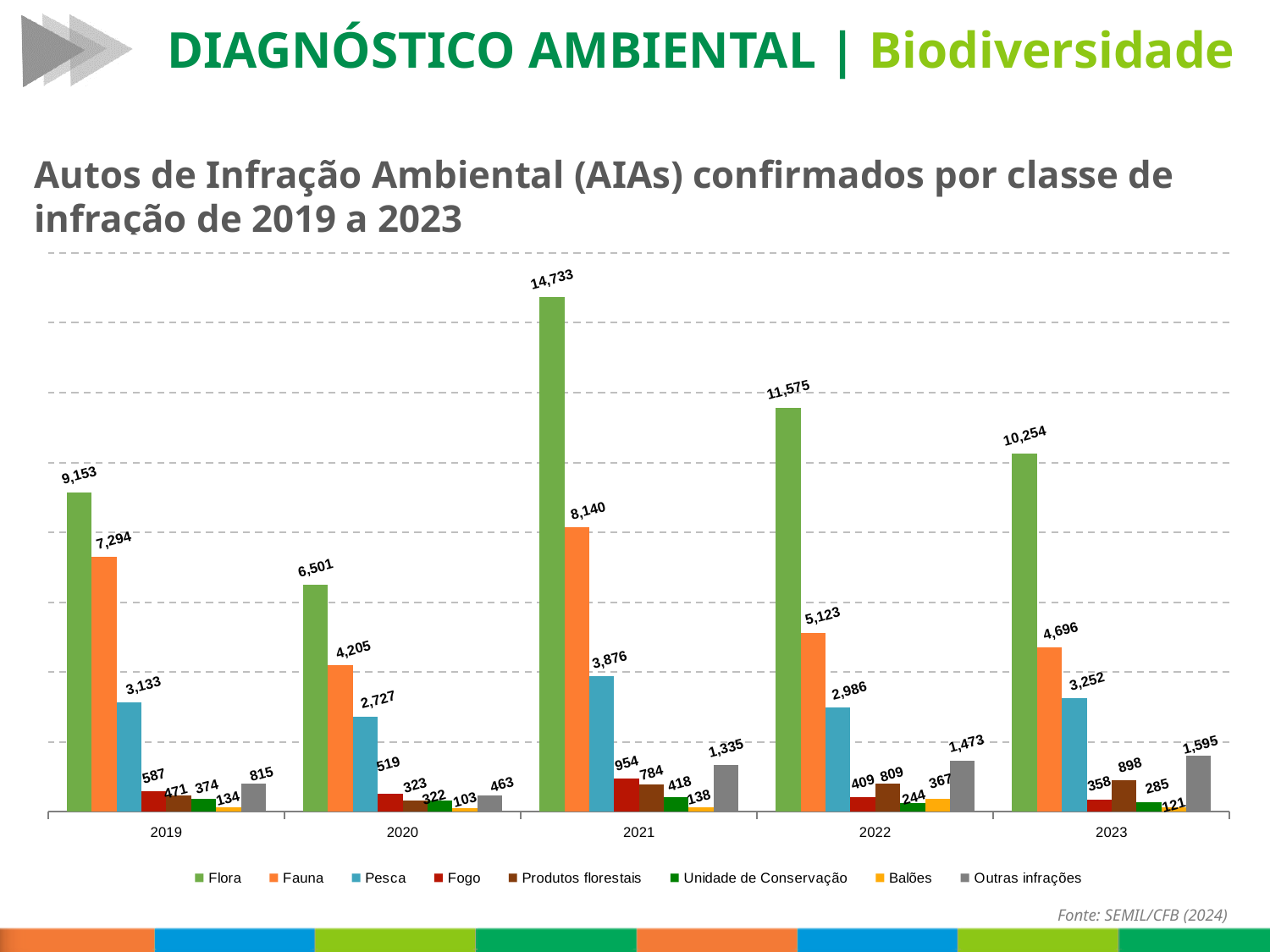
How many years are shown on the x axis? 5 What is the title of the chart? Autos de Infração Ambiental (AIAs) confirmados por classe de infração de 2019 a 2023 How many series does the legend list? 8 In which year is the Balões value lowest? 2020 What kind of chart is shown on the slide? bar chart What is the value for Flora in 2021? 14,733 What is the difference between the Flora values for 2021 and 2022? 3,158 What is the value for Pesca in 2023? 3,252 Do the Flora values rise or fall from 2021 to 2023? fall Which year has the larger Fauna value, 2019 or 2021? 2021 In which year is the Flora value highest? 2021 What is the value for Outras infrações in 2022? 1,473